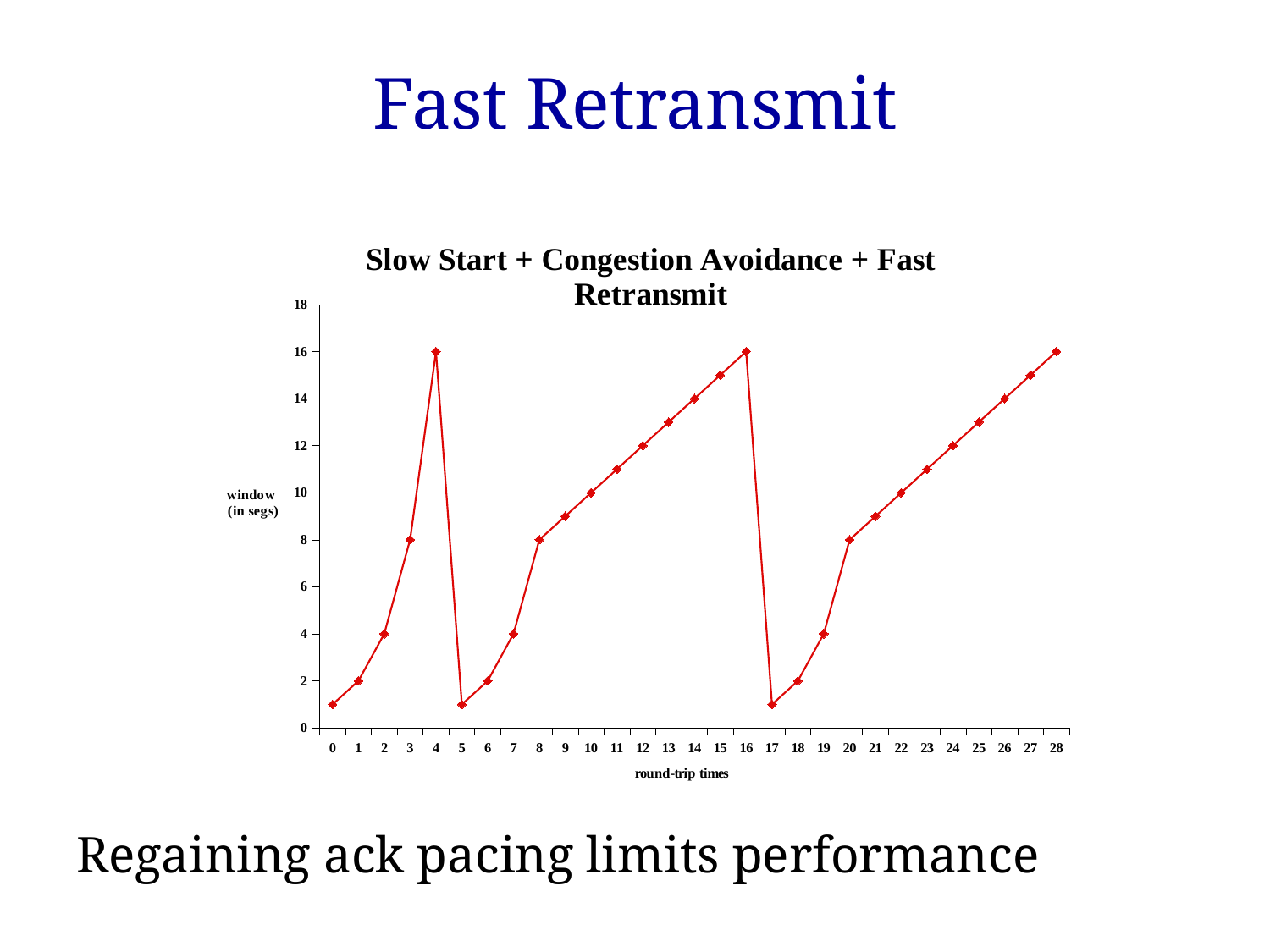
Is the window size at round-trip time 17 greater or less than 2? less What is the window size (in segs) at round-trip time 4? 16 What is the window size (in segs) at round-trip time 3? 8 Does the window size rise or fall from round-trip time 5 to round-trip time 16? rise What kind of chart is shown on the slide? line chart Which has a larger window size, round-trip time 2 or round-trip time 8? round-trip time 8 What is the window size (in segs) at round-trip time 20? 8 What is the title of the chart? Slow Start + Congestion Avoidance + Fast Retransmit What is the difference in window size between round-trip time 4 and round-trip time 3? 8 What is the label of the x axis? round-trip times What is the window size (in segs) at round-trip time 28? 16 How many data points are plotted on the chart? 29